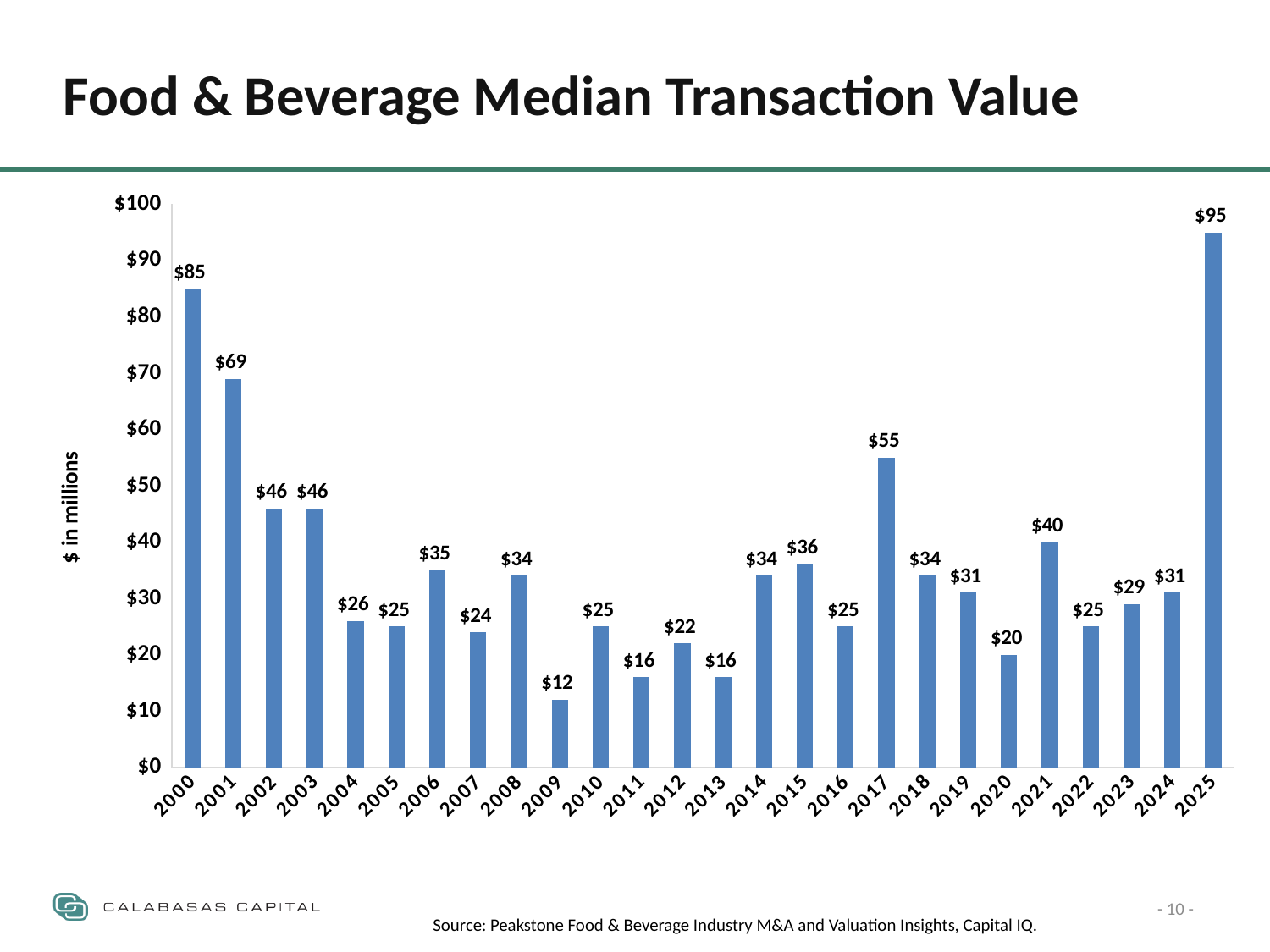
Which year has a larger median transaction value, 2015 or 2018? 2015 What is the label on the vertical axis? $ in millions What is the difference between the median transaction values for 2025 and 2000? $10 How many years are shown on the x axis? 26 What is the median transaction value for 2017? $55 What is the difference between the median transaction values for 2001 and 2002? $23 Which year has the highest median transaction value? 2025 Which year has the lowest median transaction value? 2009 What kind of chart is shown on the slide? Bar chart Is the median transaction value for 2020 greater or less than $30? less What is the median transaction value for 2009? $12 What is the median transaction value for 2021? $40